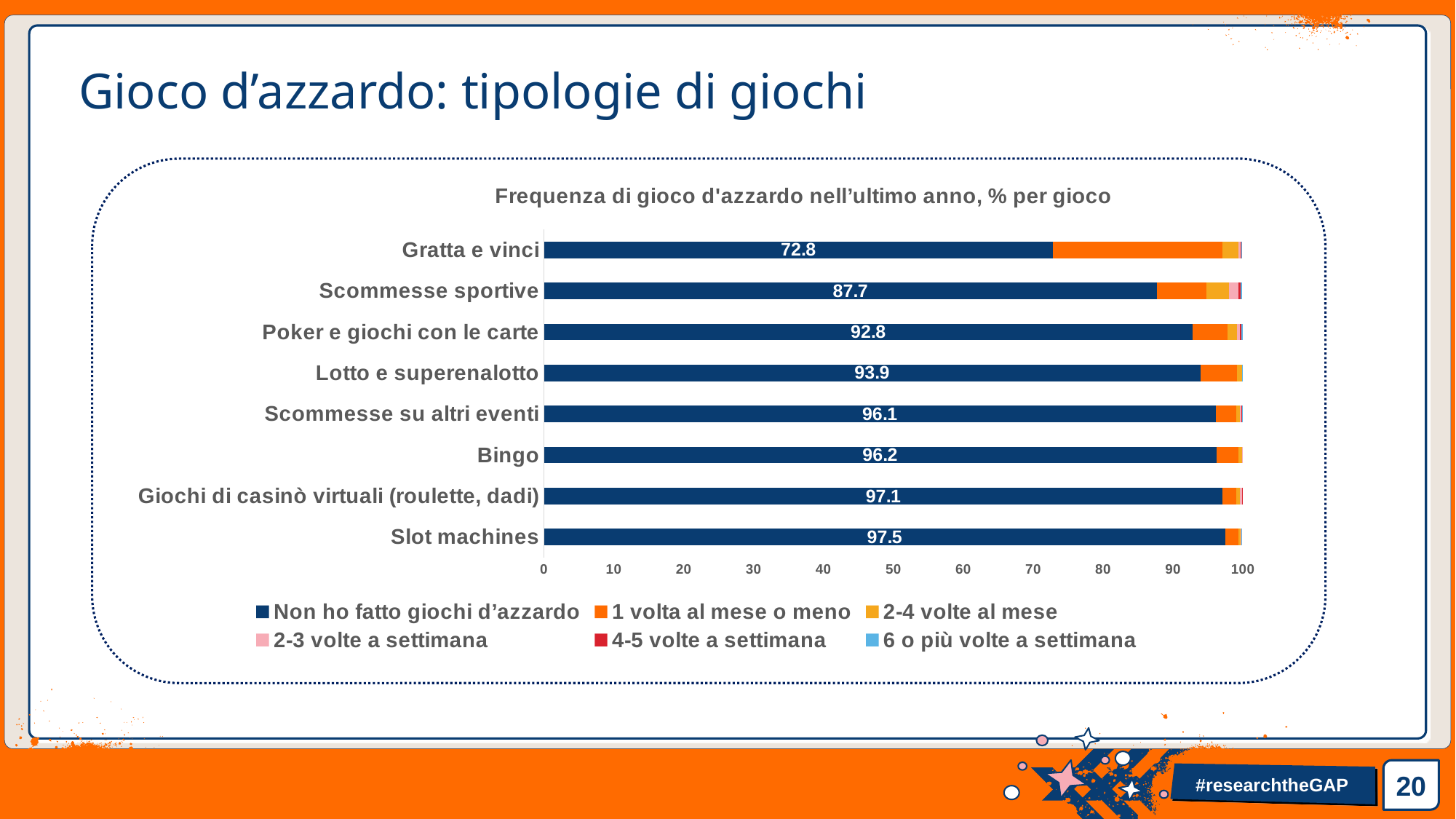
How many games (categories) are shown in the chart? 8 How many series does the legend list? 6 What is the value of "Non ho fatto giochi d'azzardo" for Scommesse sportive? 87.7 What is the value of "Non ho fatto giochi d'azzardo" for Gratta e vinci? 72.8 What is the difference between the "Non ho fatto giochi d'azzardo" values for Slot machines and Gratta e vinci? 24.7 What kind of chart is shown on the slide? Stacked bar chart What is the value of "Non ho fatto giochi d'azzardo" for Lotto e superenalotto? 93.9 Which has a larger "Non ho fatto giochi d'azzardo" value, Poker e giochi con le carte or Scommesse sportive? Poker e giochi con le carte What is the title of the chart? Frequenza di gioco d'azzardo nell'ultimo anno, % per gioco What is the value of "Non ho fatto giochi d'azzardo" for Giochi di casinò virtuali (roulette, dadi)? 97.1 Which game has the lowest value for "Non ho fatto giochi d'azzardo"? Gratta e vinci Which game has the highest value for "Non ho fatto giochi d'azzardo"? Slot machines